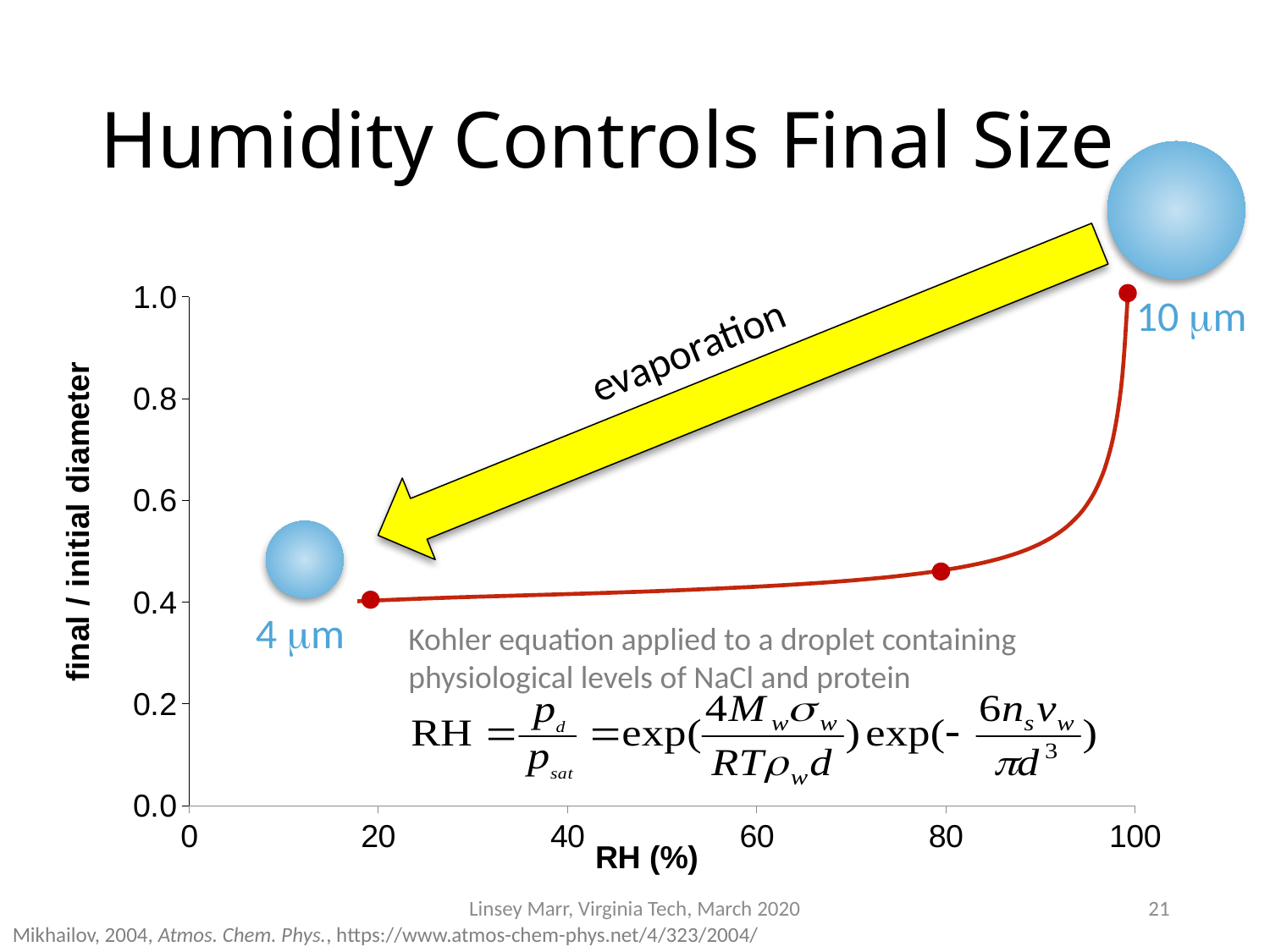
How many data points are marked on the curve? 3 Is the final / initial diameter at RH 100% greater or less than 0.8? greater What label is shown on the x axis of the chart? RH (%) What is the title of the chart on the slide? Humidity Controls Final Size Does the final / initial diameter rise or fall as RH (%) increases? rise Is the final / initial diameter at RH 20% greater or less than 0.6? less What kind of chart is shown on the slide? line chart What is the highest tick value shown on the y axis of the chart? 1.0 Is the final / initial diameter at RH 80% greater or less than 0.6? less Which has the larger final / initial diameter, the point at RH 100% or the point at RH 80%? RH 100%